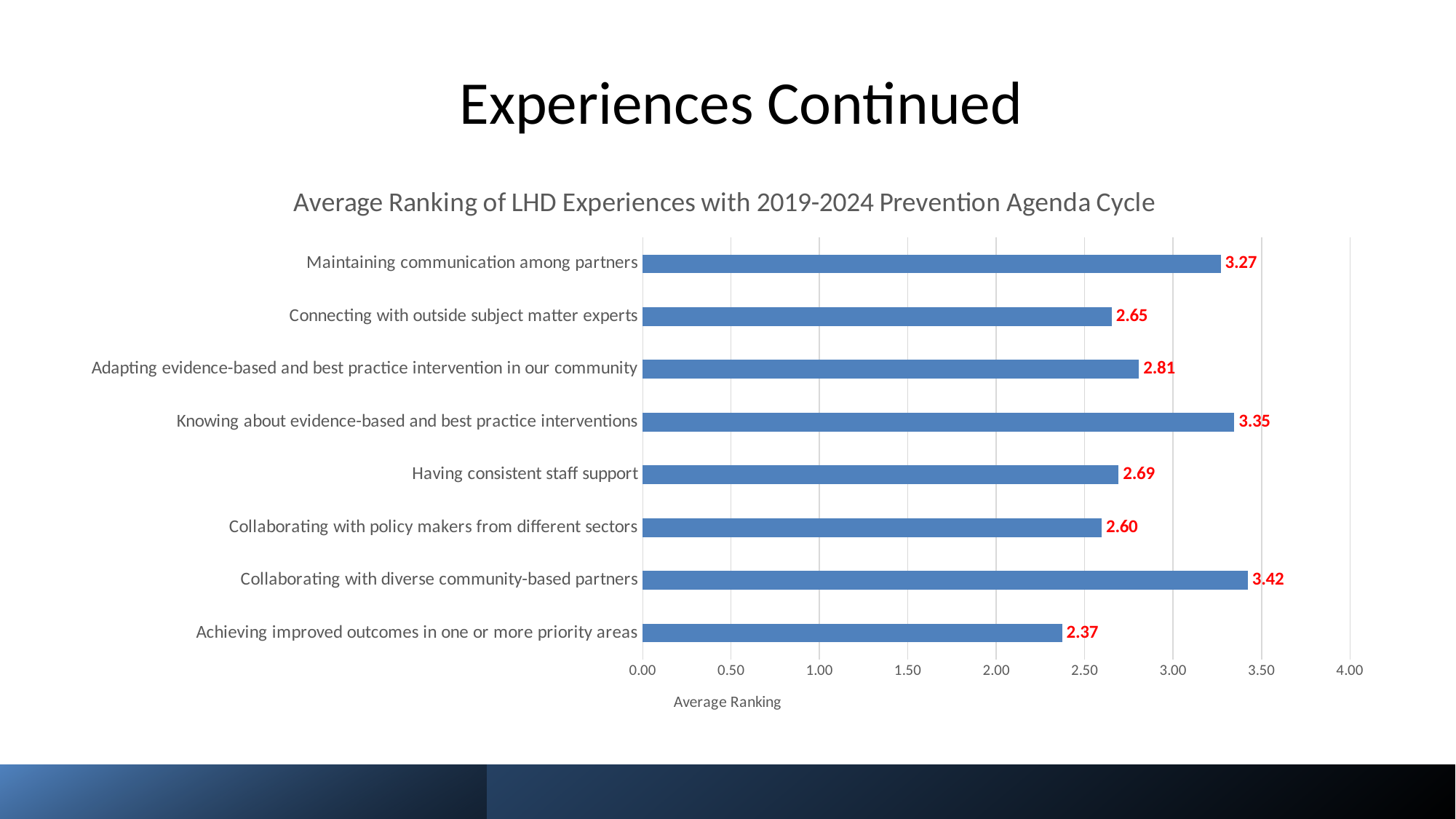
Which experience has the highest average ranking? Collaborating with diverse community-based partners What is the label of the horizontal axis? Average Ranking What is the average ranking for Achieving improved outcomes in one or more priority areas? 2.37 What is the average ranking for Maintaining communication among partners? 3.27 Is the value for Collaborating with policy makers from different sectors greater or less than 3.00? less What kind of chart is shown on the slide? Bar chart How many experiences are shown in the chart? 8 Which experience has the lowest average ranking? Achieving improved outcomes in one or more priority areas What is the difference between the average ranking for Collaborating with diverse community-based partners and Achieving improved outcomes in one or more priority areas? 1.05 Which has a higher average ranking: Knowing about evidence-based and best practice interventions or Adapting evidence-based and best practice intervention in our community? Knowing about evidence-based and best practice interventions What is the average ranking for Having consistent staff support? 2.69 What is the title of the chart? Average Ranking of LHD Experiences with 2019-2024 Prevention Agenda Cycle